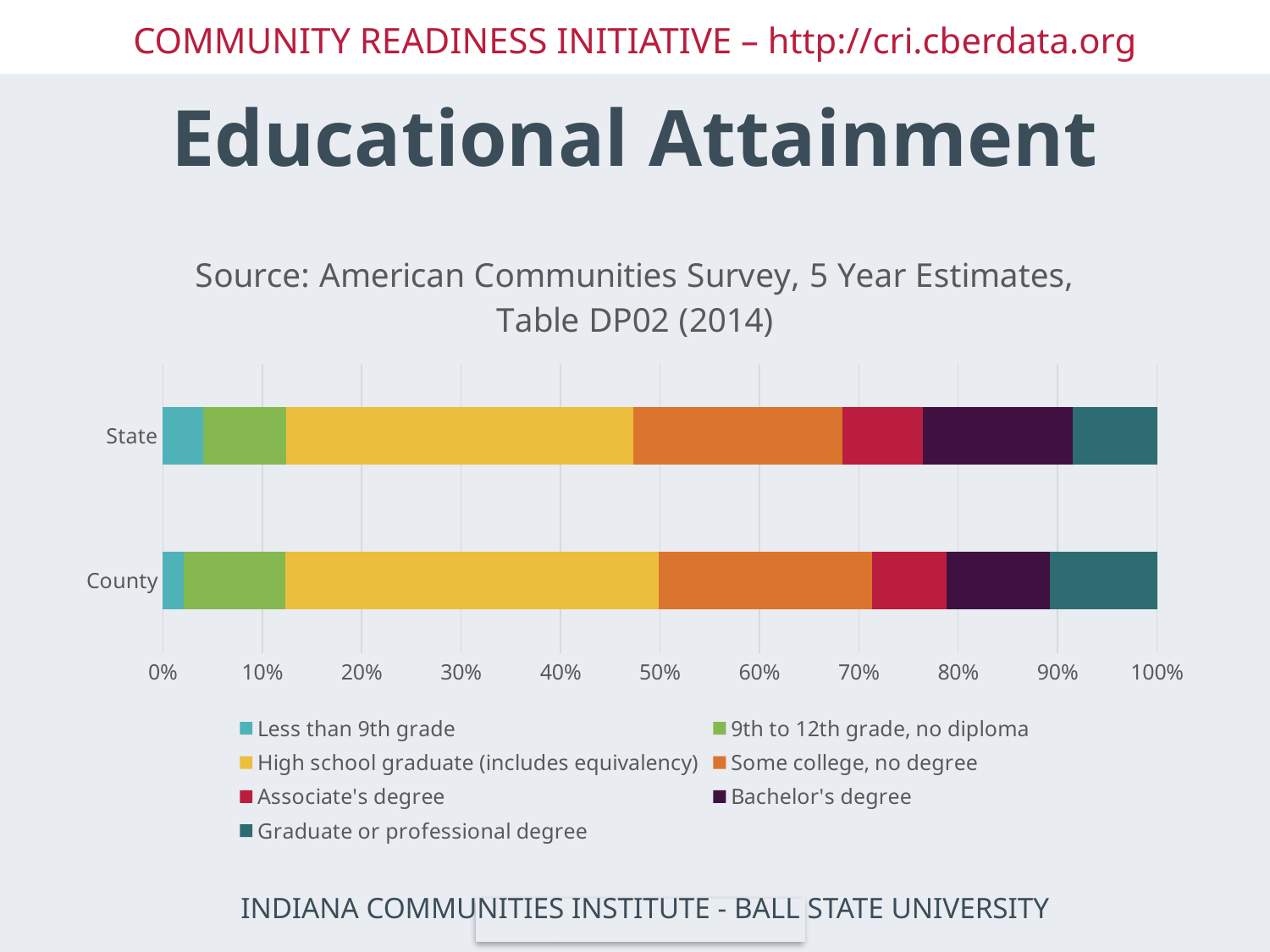
Is the High school graduate (includes equivalency) segment for County greater or less than 30%? greater What kind of chart is shown on the slide? Stacked bar chart How many categories (bars) does the chart show? 2 Is the Less than 9th grade segment for State greater or less than 10%? less How many series does the legend list? 7 Which education level makes up the largest segment of the County bar? High school graduate (includes equivalency) Which education level makes up the largest segment of the State bar? High school graduate (includes equivalency) What data source is cited in the chart title? American Communities Survey, 5 Year Estimates, Table DP02 (2014) Which has a larger Bachelor's degree share, State or County? State Which education level makes up the smallest segment of the County bar? Less than 9th grade Which has a larger Less than 9th grade share, State or County? State Is the Bachelor's degree segment for State greater or less than 10%? greater